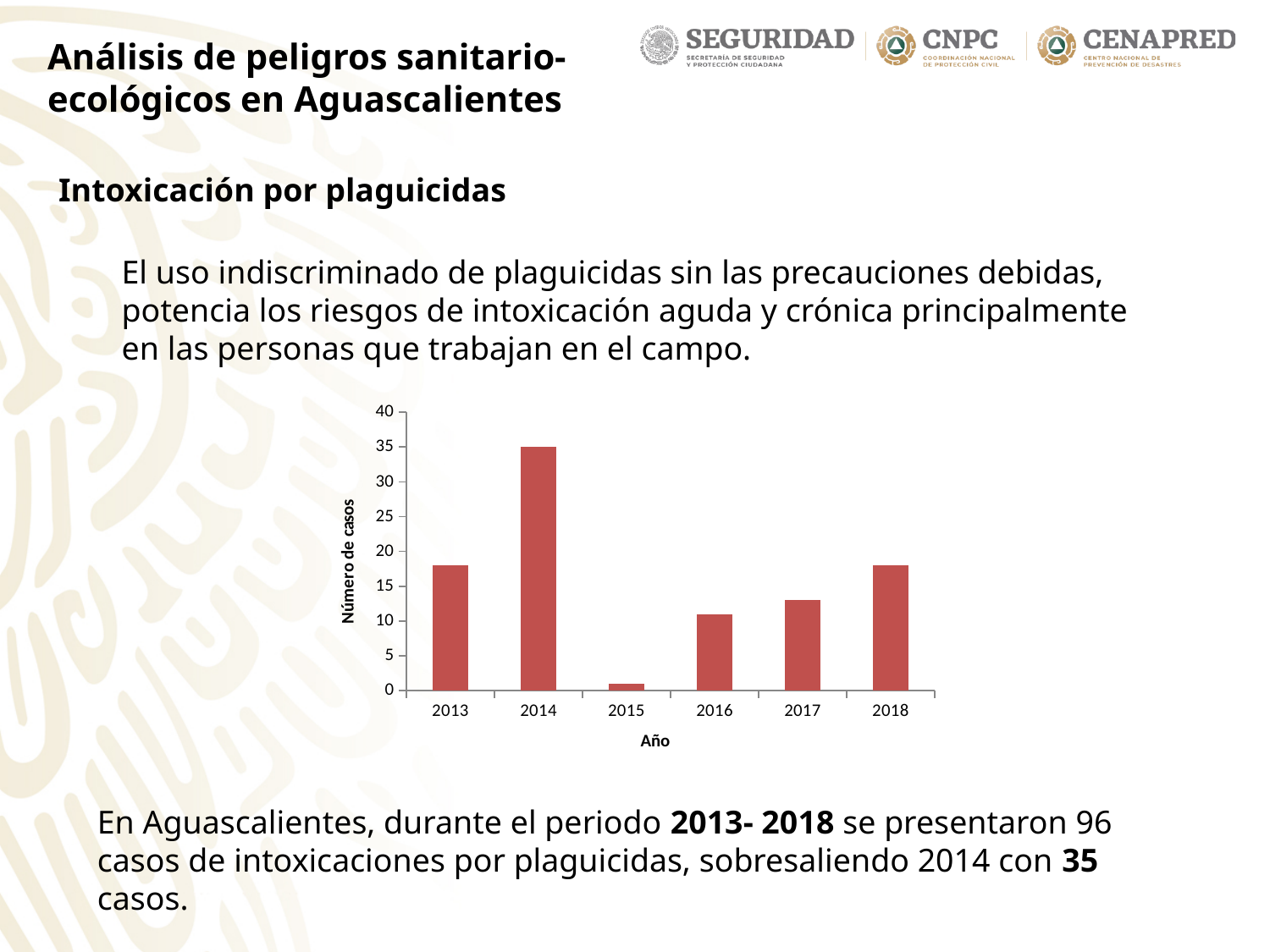
Which year has the lowest number of cases in the chart? 2015 Is the value for 2018 greater or less than 15? greater Is the value for 2015 greater or less than 5? less How many cases does the chart show for 2014? 35 Which year has more cases, 2013 or 2014? 2014 Is the value for 2013 greater or less than 15? greater How many years are shown on the x axis of the chart? 6 Which year has the highest number of cases in the chart? 2014 What is the label of the vertical axis of the chart? Número de casos From 2015 to 2018, do the values in the chart rise or fall? rise What kind of chart is shown on the slide? bar chart